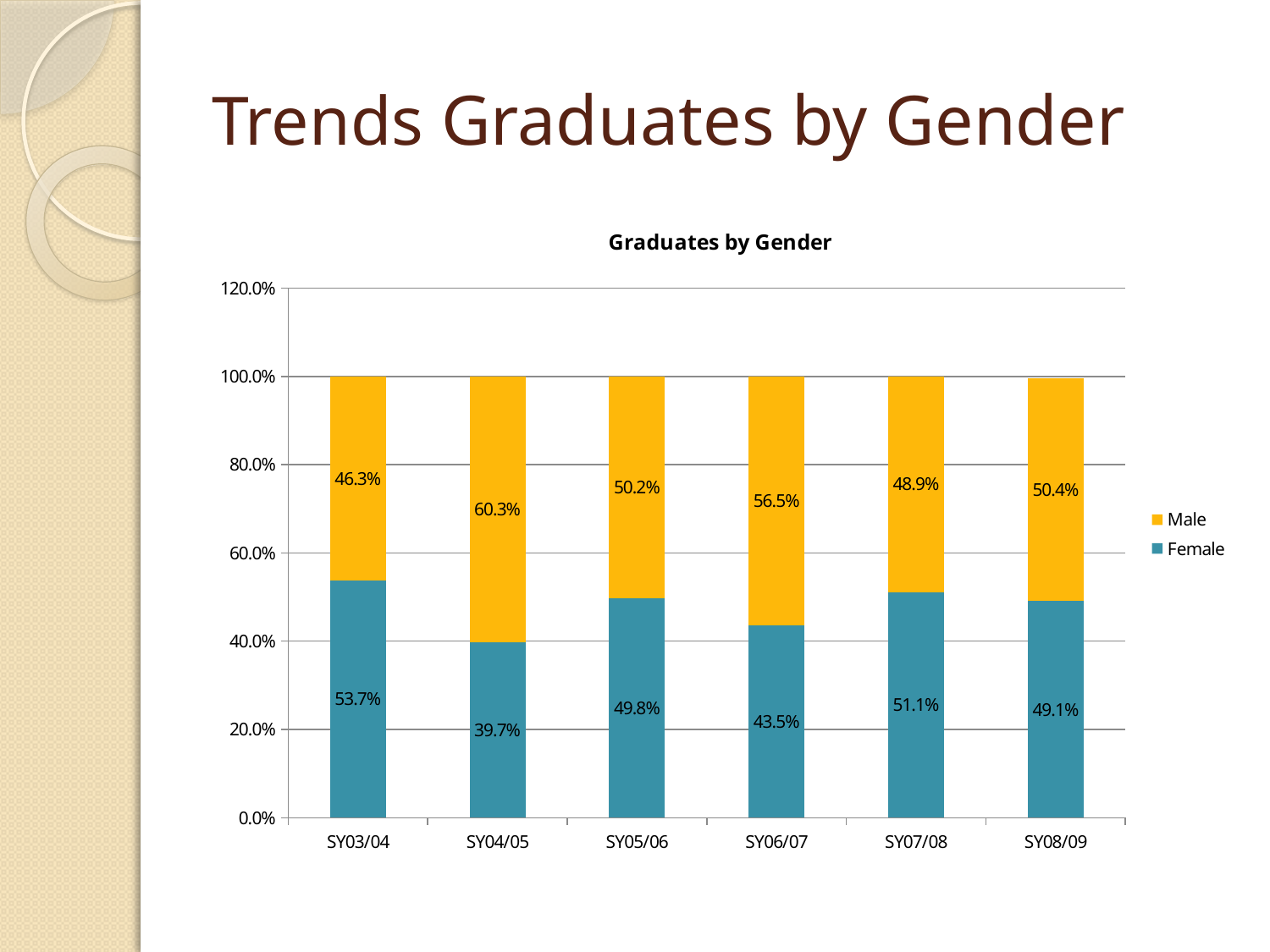
What is the Male value for SY04/05? 60.3% What is the difference between the Male and Female values for SY04/05? 20.6% How many school years are shown on the x axis? 6 What is the Female value for SY03/04? 53.7% How many series does the legend list? 2 What is the Female value for SY06/07? 43.5% Which is larger for SY07/08, the Male value or the Female value? Female What is the title of the chart? Graduates by Gender Which school year has the lowest Female value? SY04/05 Which school year has the highest Male value? SY04/05 What kind of chart is shown? Stacked bar chart What is the Male value for SY08/09? 50.4%